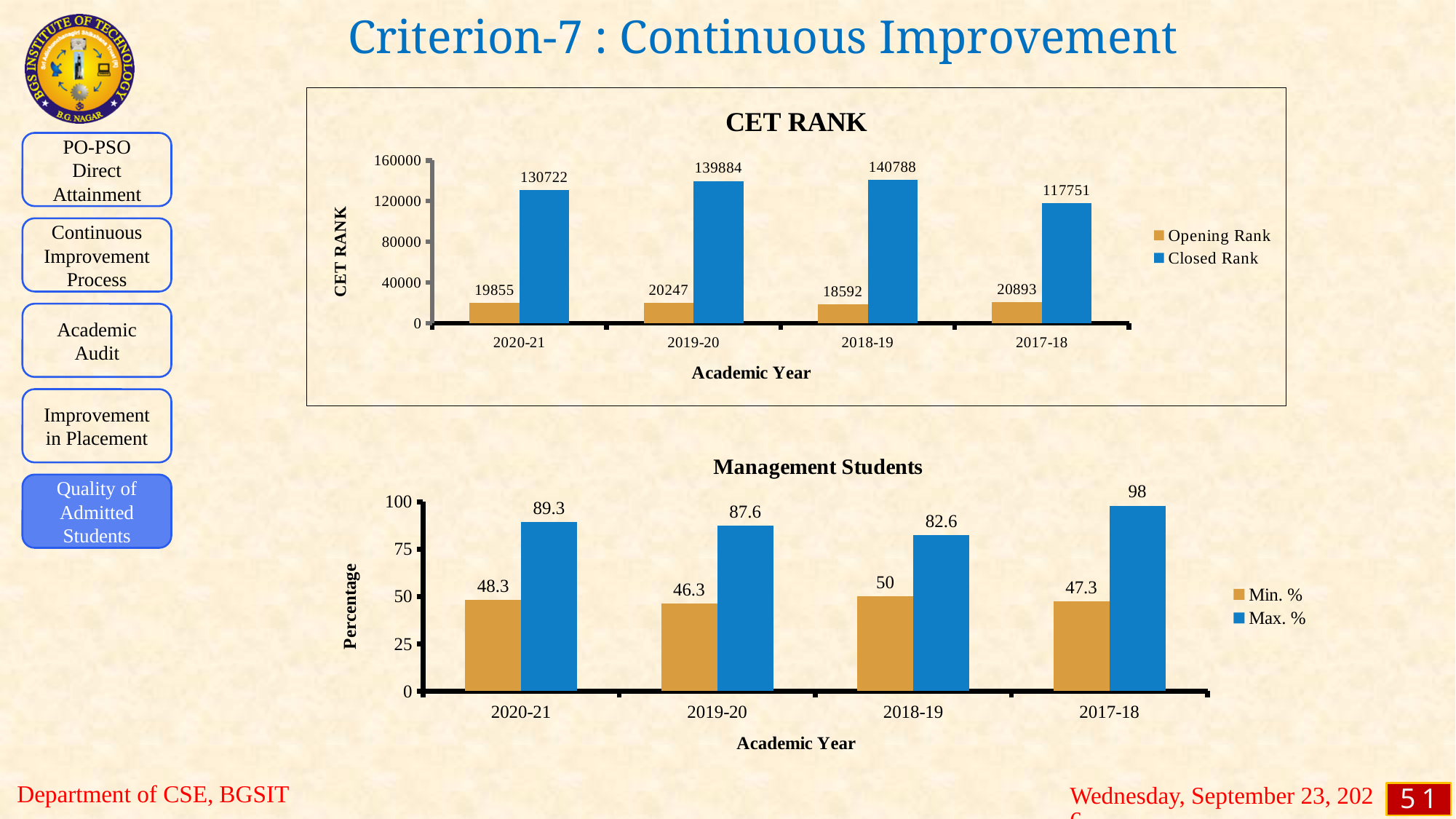
In the CET RANK chart, how many series does the legend list? 2 In the Management Students chart, what is the Min. % for 2018-19? 50 In the CET RANK chart, what is the difference between the Closed Rank and the Opening Rank for 2017-18? 96858 In the Management Students chart, which academic year has the highest Max. %? 2017-18 In the Management Students chart, how many academic years are shown on the x axis? 4 In the Management Students chart, what is the Max. % for 2019-20? 87.6 In the CET RANK chart, what is the Opening Rank for 2020-21? 19855 What kind of chart is the Management Students chart? Bar chart In the CET RANK chart, which academic year has the highest Closed Rank? 2018-19 In the Management Students chart, is the Min. % for 2020-21 larger than the Min. % for 2019-20? Yes In the CET RANK chart, what is the Closed Rank for 2018-19? 140788 In the CET RANK chart, which academic year has the lowest Opening Rank? 2018-19